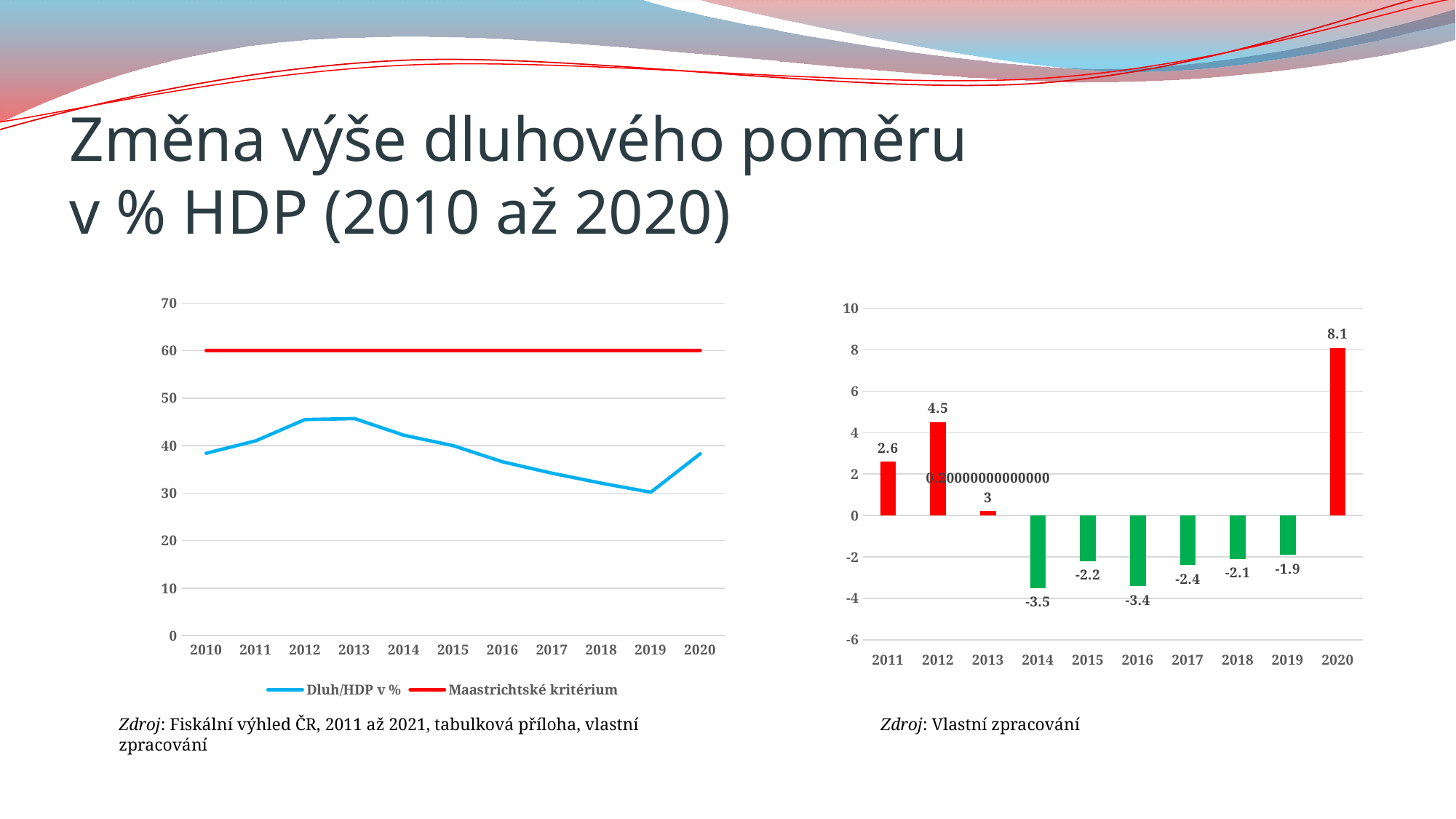
On the left chart, what value does the Maastrichtské kritérium line stay at? 60 On the left chart, how many series does the legend list? 2 On the left chart, how many years are shown on the x axis? 11 On the left chart, what kind of chart is shown? line chart On the right chart, what is the difference between the values for 2020 and 2012? 3.6 On the left chart, is the Dluh/HDP v % value for 2012 greater or less than 40? greater On the right chart, what is the value for 2015? -2.2 On the right chart, what kind of chart is shown? bar chart On the right chart, what is the value for 2020? 8.1 On the left chart, is the Dluh/HDP v % value for 2010 greater or less than 40? less On the right chart, which year has the lowest value? 2014 On the right chart, which year has the highest value? 2020